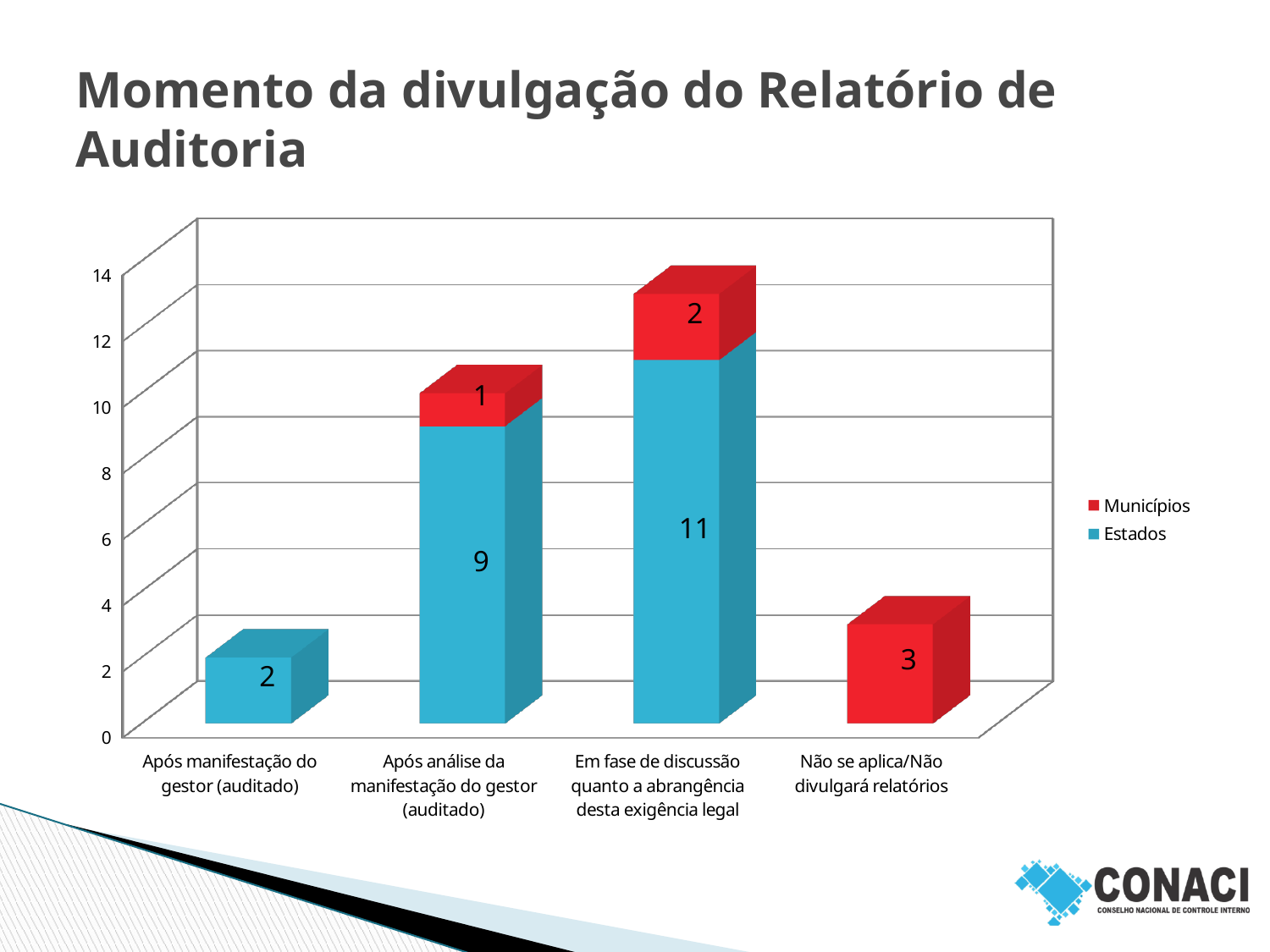
What is the value for Municípios in the category 'Não se aplica/Não divulgará relatórios'? 3 Which colour represents the Municípios series in the legend? red Which category has the highest value for Estados? Em fase de discussão quanto a abrangência desta exigência legal What kind of chart is shown on the slide? stacked bar chart What is the difference between the Estados values for 'Em fase de discussão quanto a abrangência desta exigência legal' and 'Após análise da manifestação do gestor (auditado)'? 2 What is the total of the stacked bar for 'Em fase de discussão quanto a abrangência desta exigência legal'? 13 How many series does the legend list? 2 What is the value for Estados in the category 'Em fase de discussão quanto a abrangência desta exigência legal'? 11 Which category has the highest value for Municípios? Não se aplica/Não divulgará relatórios What is the value for Estados in the category 'Após manifestação do gestor (auditado)'? 2 How many categories are shown on the x axis? 4 What is the value for Municípios in the category 'Após análise da manifestação do gestor (auditado)'? 1